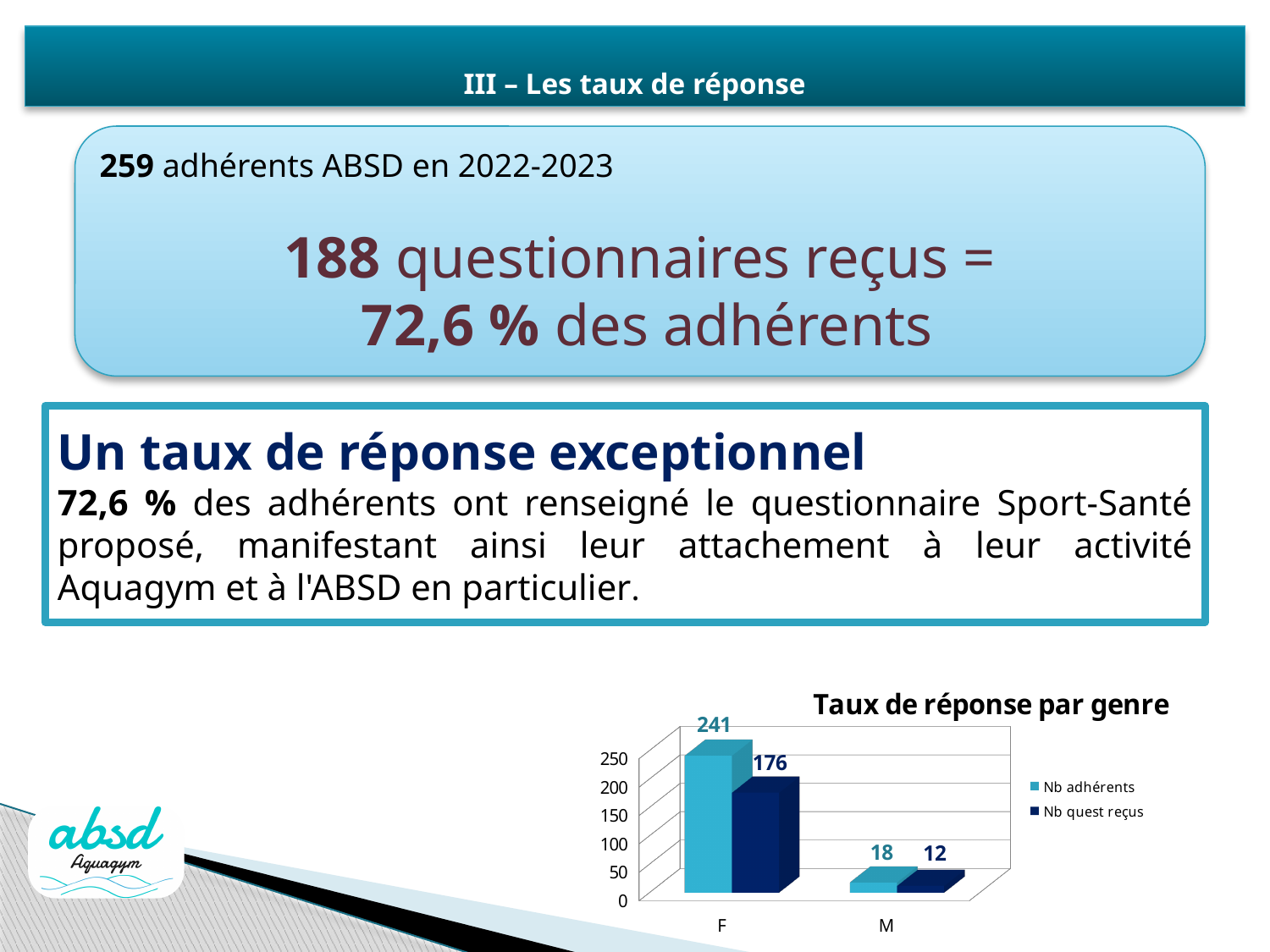
How many categories are shown on the x axis of the chart? 2 How many series does the chart legend list? 2 What is the value of Nb adhérents for category M? 18 Which category has the highest Nb adhérents value? F What is the difference between Nb adhérents for F and Nb adhérents for M? 223 What is the title of the chart? Taux de réponse par genre Which is larger for category M: Nb adhérents or Nb quest reçus? Nb adhérents Which category has the lowest Nb quest reçus value? M What is the value of Nb quest reçus for category M? 12 What is the difference between Nb adhérents and Nb quest reçus for category F? 65 What is the value of Nb adhérents for category F? 241 What is the value of Nb quest reçus for category F? 176